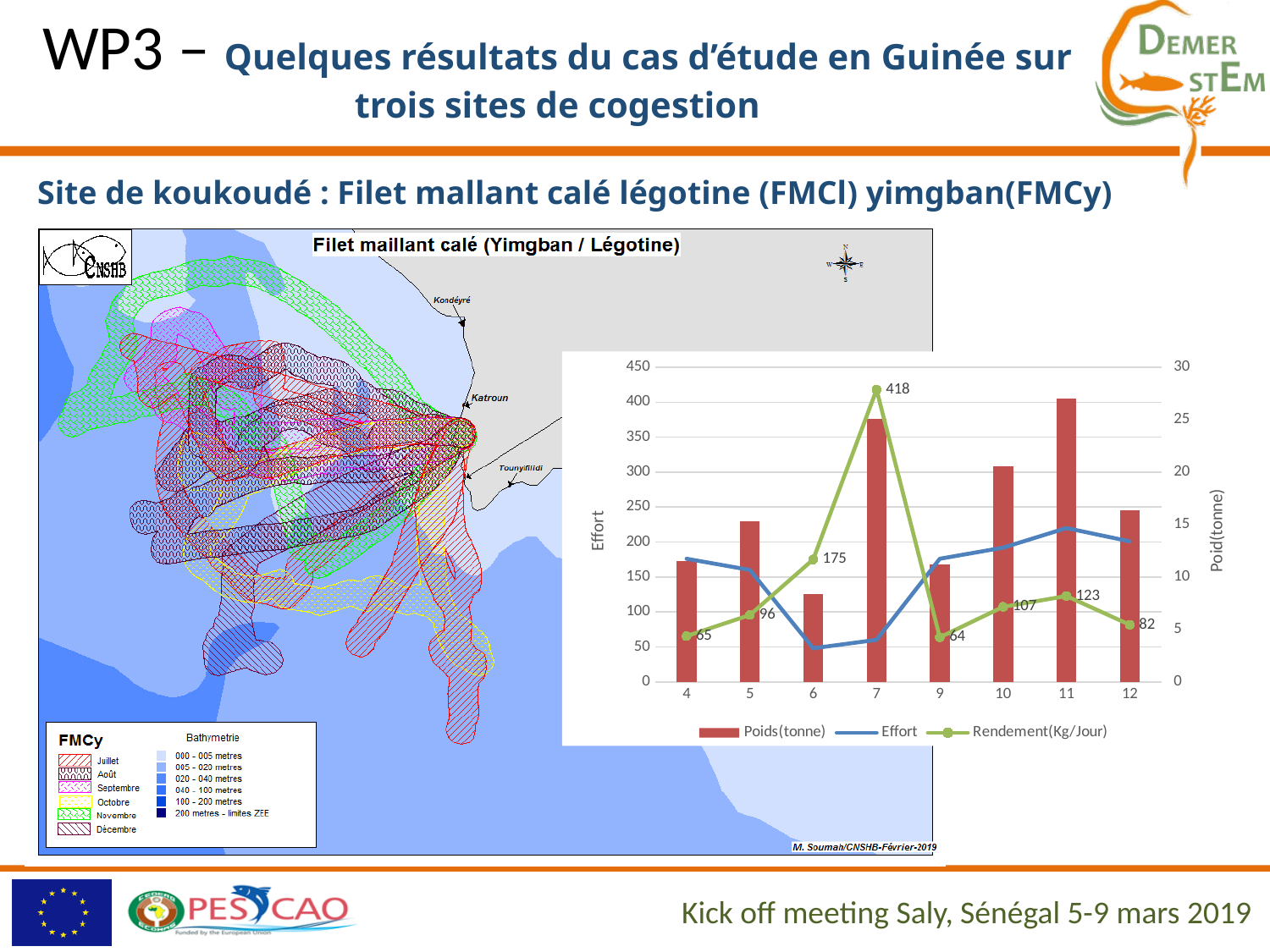
Does Rendement(Kg/Jour) rise or fall from month 4 to month 7? rise Is the Poids(tonne) bar at month 11 greater or less than 25? greater What is the difference between the Rendement(Kg/Jour) values at month 7 and month 6? 243 How many series does the chart legend list? 3 Which is larger in the chart: the Rendement(Kg/Jour) value at month 11 or at month 10? Month 11 What is the Rendement(Kg/Jour) value at month 12 in the chart? 82 How many months are shown on the x axis of the chart? 8 Is the Effort value at month 6 greater or less than 100? less At which month is Rendement(Kg/Jour) lowest in the chart? 9 What is the Rendement(Kg/Jour) value at month 5 in the chart? 96 What is the Rendement(Kg/Jour) value at month 7 in the chart? 418 At which month is Rendement(Kg/Jour) highest in the chart? 7